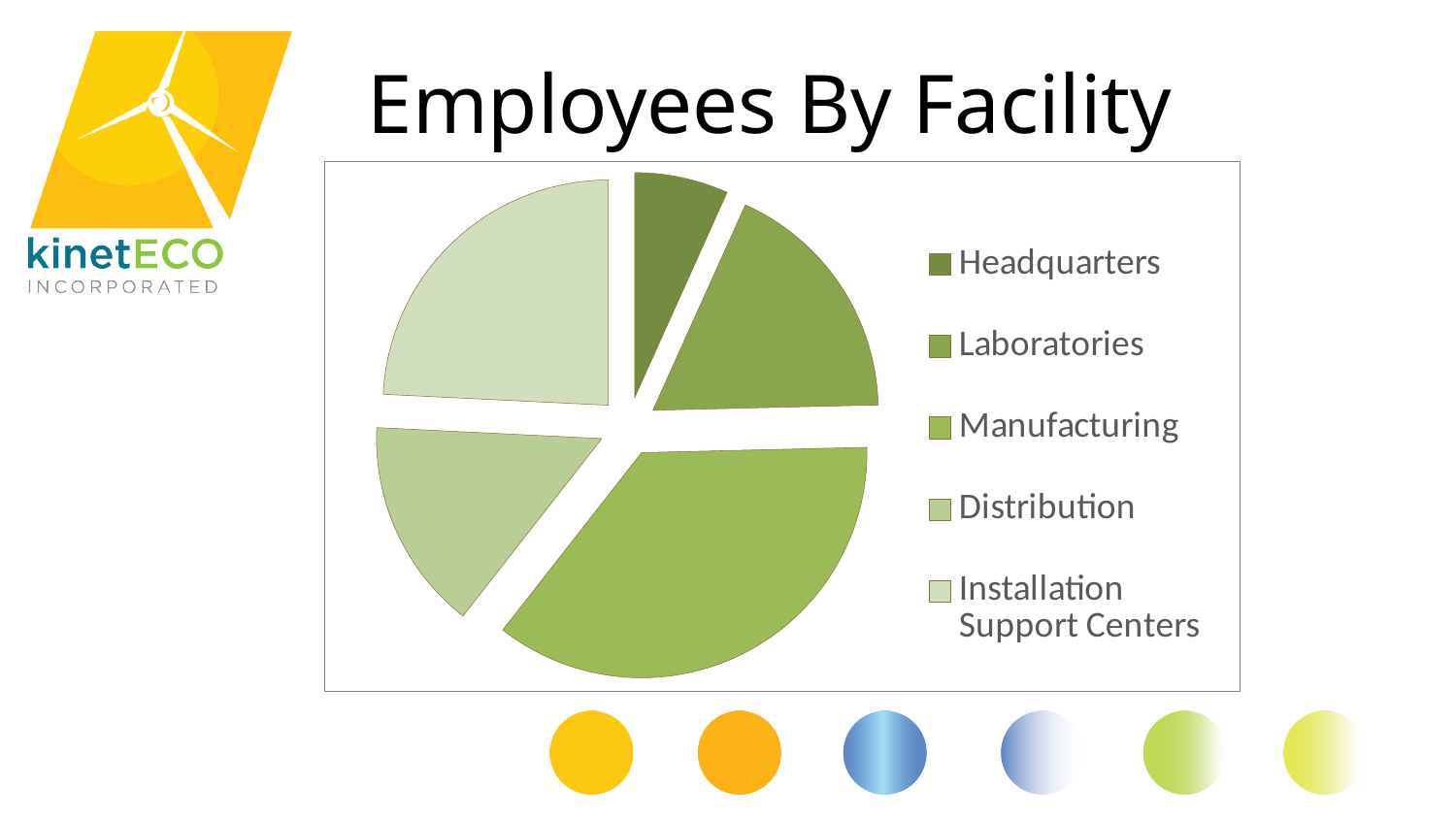
Which has a larger share of employees, Laboratories or Headquarters? Laboratories What is the title of the chart? Employees By Facility Which has a larger share of employees, Installation Support Centers or Distribution? Installation Support Centers Which legend entry is listed last in the legend? Installation Support Centers Which has a larger share of employees, Manufacturing or Installation Support Centers? Manufacturing How many entries does the legend list? 5 How many slices does the pie chart have? 5 Which facility has the largest share of employees? Manufacturing Which facility has the smallest share of employees? Headquarters What kind of chart is shown on the slide? Pie chart